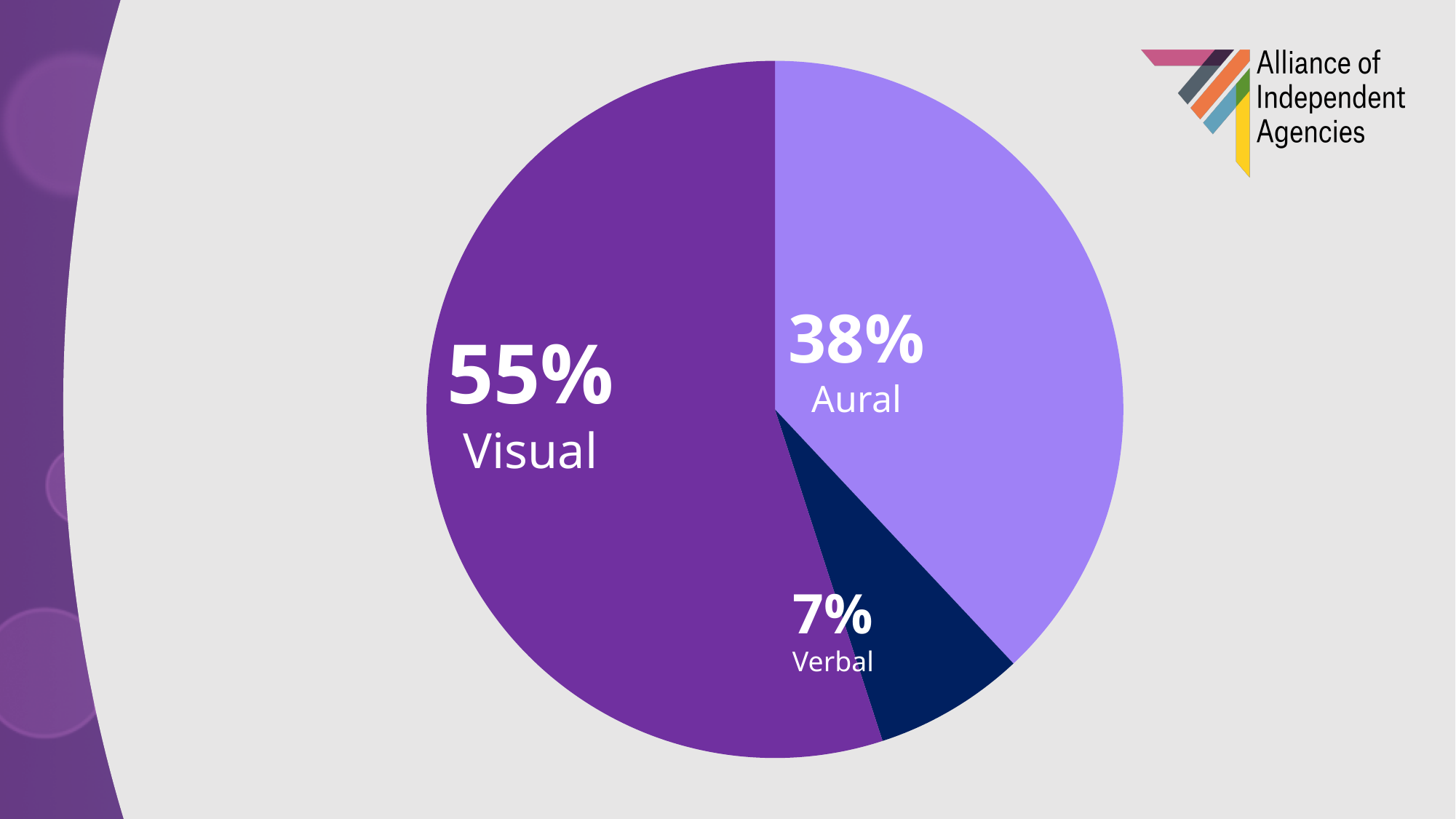
Which slice of the pie is the largest? Visual What colour is the Verbal slice? dark navy blue How many slices does the pie chart have? 3 What percentage is shown for Verbal? 7% What percentage is shown for Aural? 38% What is the difference in percentage points between Visual and Aural? 17 Which is larger, the Aural slice or the Verbal slice? Aural What is the difference in percentage points between Aural and Verbal? 31 What share of the pie does the Visual slice represent? 55% What kind of chart is shown on the slide? pie chart What percentage is shown for Visual? 55% Which slice of the pie is the smallest? Verbal